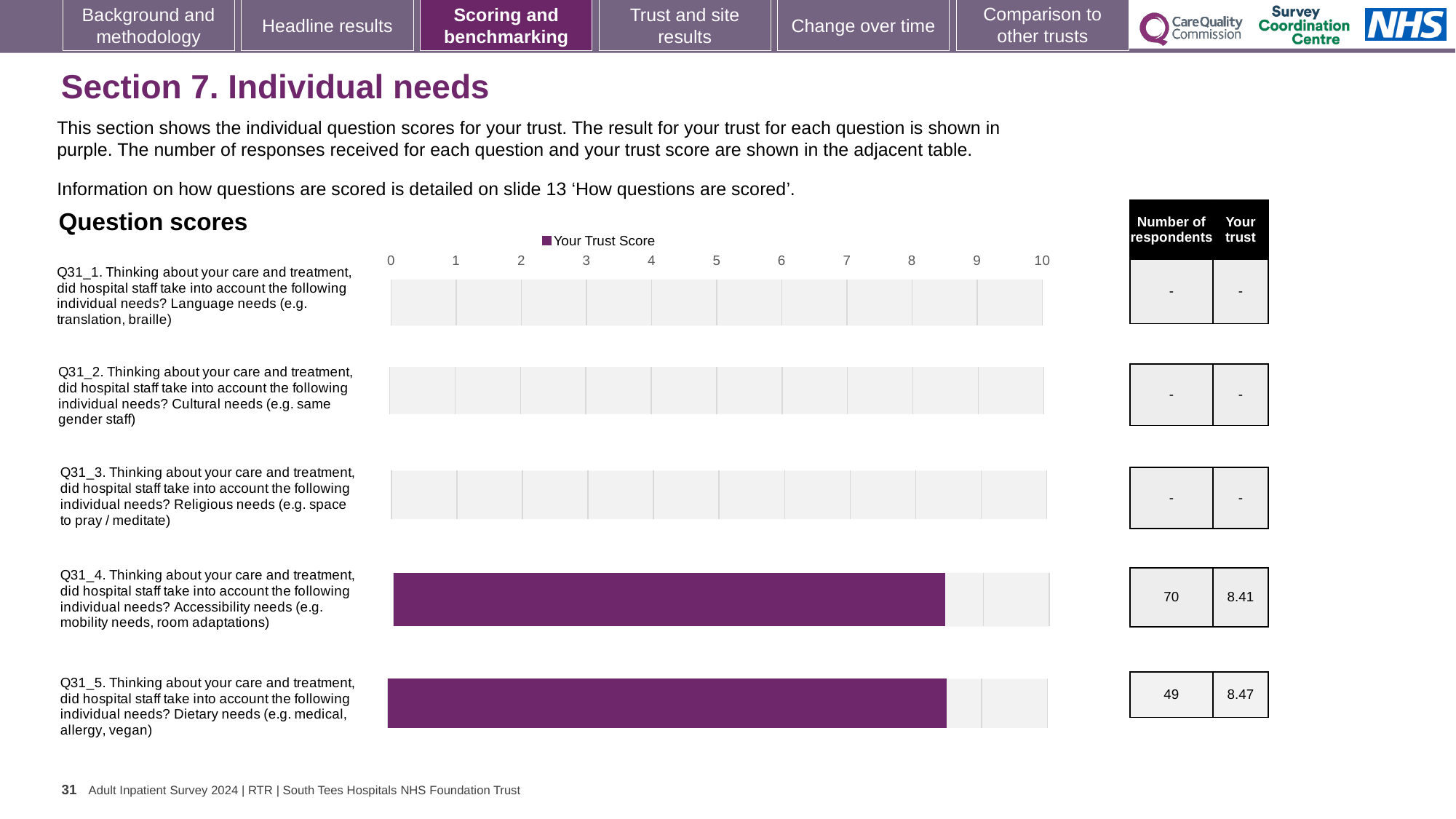
What is the trust score for Q31_4 (Accessibility needs)? 8.41 How many series does the chart legend list? 1 How many respondents answered Q31_4 (Accessibility needs)? 70 What kind of chart is used to show the question scores? Bar chart What is the difference between the trust scores for Q31_5 and Q31_4? 0.06 Is the trust score for Q31_5 (Dietary needs) greater or less than 9? less Is the trust score for Q31_4 (Accessibility needs) greater or less than 8? greater How many respondents answered Q31_5 (Dietary needs)? 49 Which question has the higher trust score, Q31_4 or Q31_5? Q31_5 What is the trust score for Q31_5 (Dietary needs)? 8.47 What is the name of the series shown in the chart legend? Your Trust Score How many questions are listed in the Question scores chart? 5